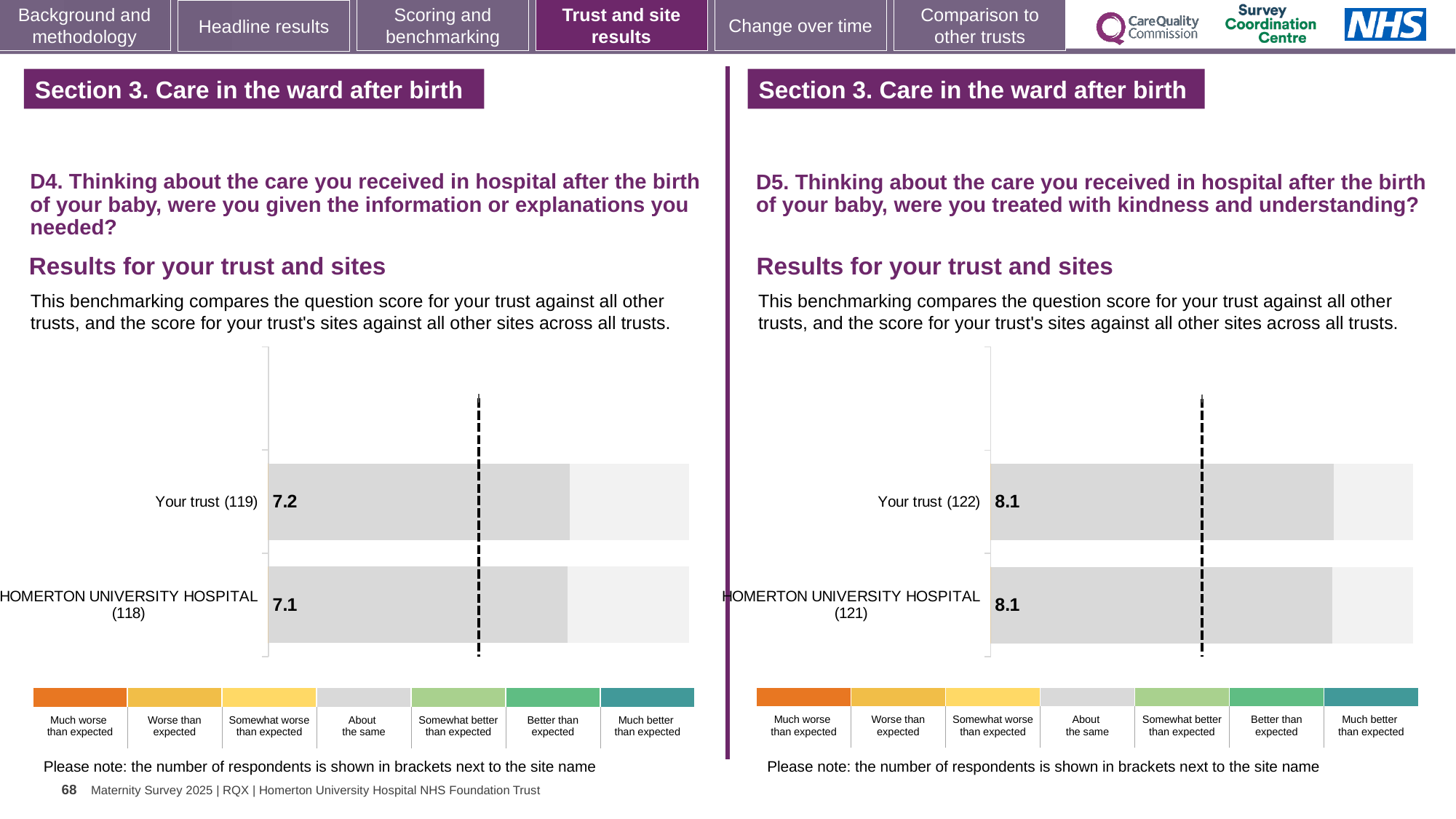
In the left chart (D4), what is the difference between the score for Your trust and the score for HOMERTON UNIVERSITY HOSPITAL? 0.1 How many bars are plotted in the right chart (D5)? 2 In the right chart (D5), what is the score for Your trust? 8.1 In the right chart (D5), what is the score for HOMERTON UNIVERSITY HOSPITAL? 8.1 Is the score for Your trust in the right chart (D5) higher or lower than the score for Your trust in the left chart (D4)? Higher In the right chart (D5), what is the difference between the score for Your trust and the score for HOMERTON UNIVERSITY HOSPITAL? 0 What kind of chart is used for the D4 results on the left? Bar chart In the left chart (D4), how many respondents are shown in brackets for Your trust? 119 How many bars are plotted in the left chart (D4)? 2 In the right chart (D5), how many respondents are shown in brackets for HOMERTON UNIVERSITY HOSPITAL? 121 In the left chart (D4), what is the score for HOMERTON UNIVERSITY HOSPITAL? 7.1 In the left chart (D4), what is the score for Your trust? 7.2